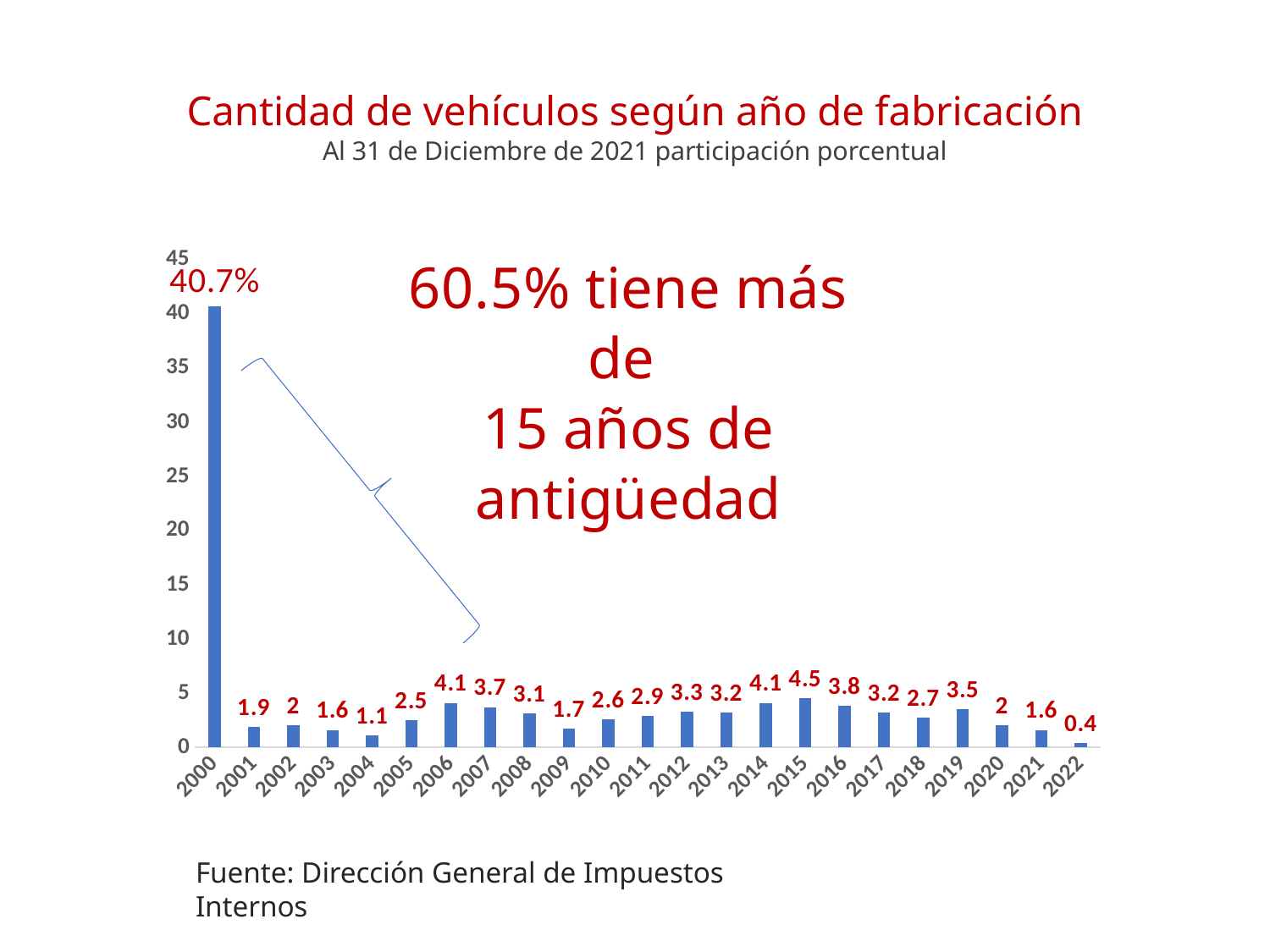
Which year has the highest value? 2000 What value is shown for the year 2015? 4.5 What value is shown for the year 2000? 40.7% Which is larger, the value for 2006 or the value for 2007? 2006 How many years are shown on the x axis? 23 What is the title of the chart? Cantidad de vehículos según año de fabricación Is the value for 2000 greater or less than 40? greater What is the difference between the values for 2015 and 2014? 0.4 What value is shown for the year 2022? 0.4 What kind of chart is shown on the slide? Bar chart What value is shown for the year 2009? 1.7 Which year has the lowest value? 2022